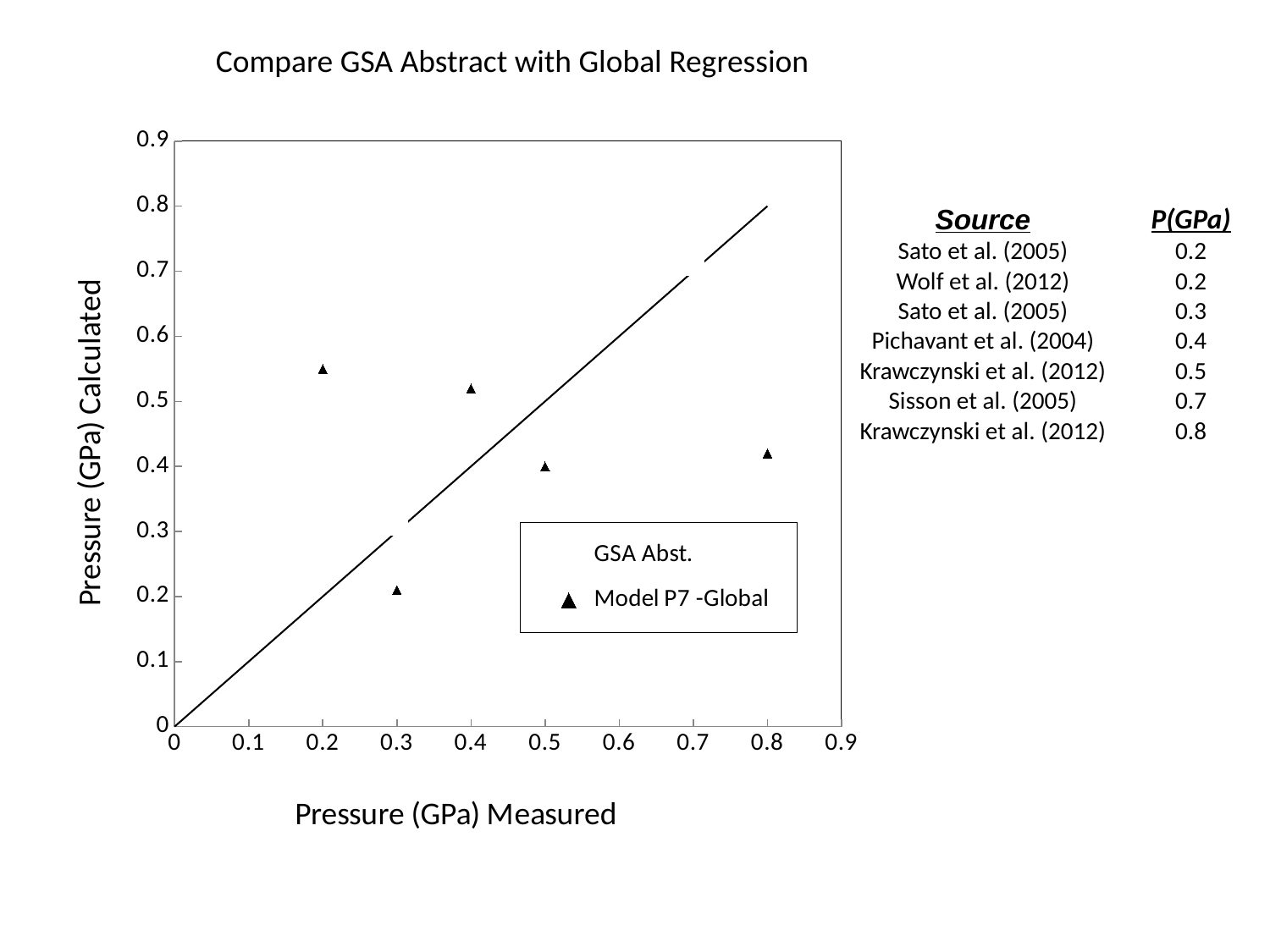
Is the calculated pressure for the point at measured pressure 0.4 greater or less than 0.4? greater What is the title of the chart? Compare GSA Abstract with Global Regression At which measured pressure is the point with the lowest calculated pressure? 0.3 What is the label of the x axis? Pressure (GPa) Measured Is the calculated pressure for the point at measured pressure 0.3 greater or less than 0.3? less Is the calculated pressure for the point at measured pressure 0.2 greater or less than 0.5? greater What kind of chart is shown on the slide? scatter chart Which point has the higher calculated pressure: the one at measured pressure 0.2 or the one at measured pressure 0.3? 0.2 How many entries does the chart legend list? 2 How many triangle data points are plotted on the chart? 5